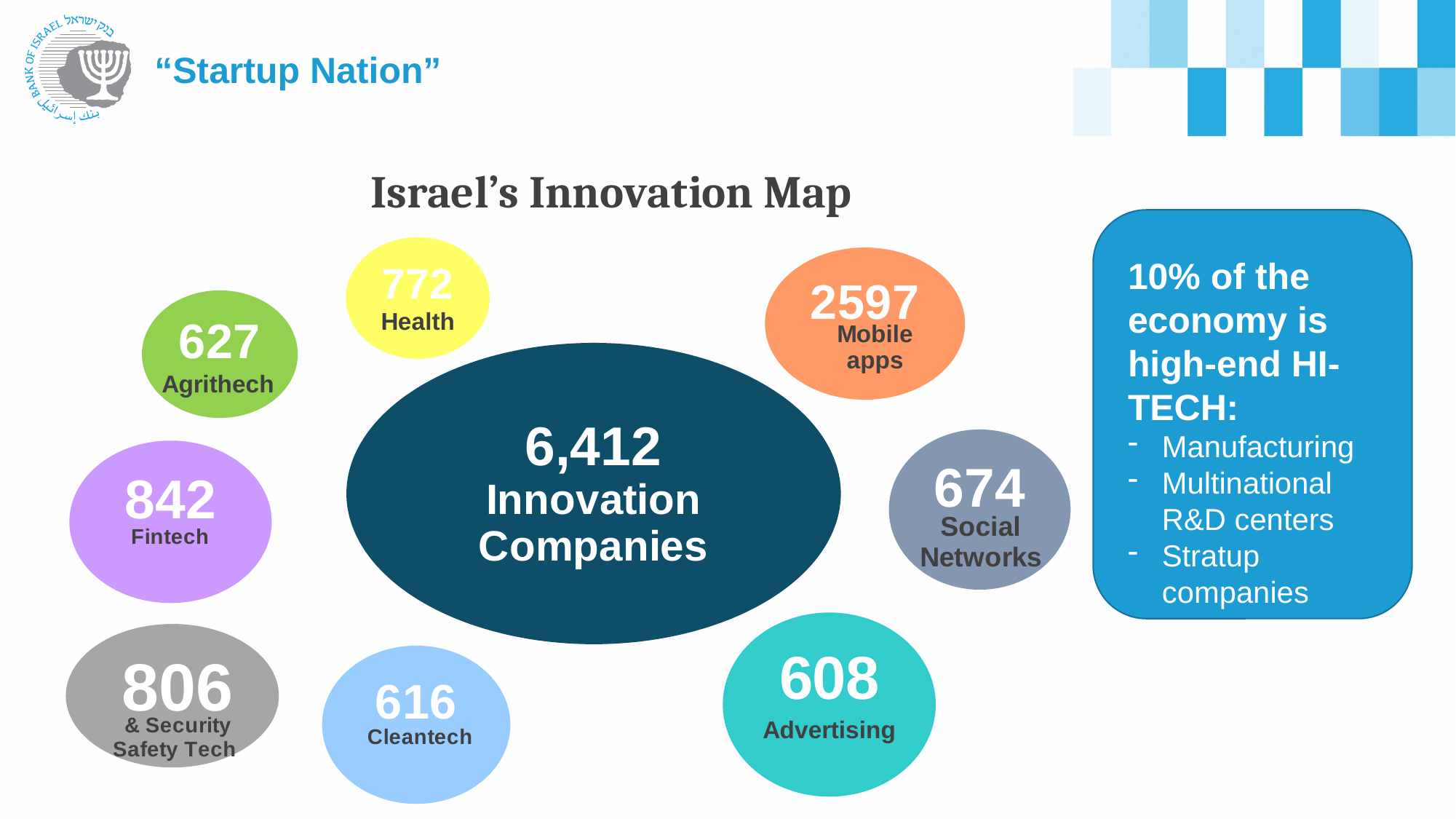
In the Israel's Innovation Map diagram, what is the value shown for Fintech? 842 In the Israel's Innovation Map diagram, which sector has the highest number of companies? Mobile apps In the Israel's Innovation Map diagram, which sector has the lowest number of companies? Advertising In the Israel's Innovation Map diagram, what is the value shown for Social Networks? 674 In the Israel's Innovation Map diagram, which has a larger value: Agrithech or Social Networks? Social Networks In the Israel's Innovation Map diagram, what is the value shown for Mobile apps? 2597 In the Israel's Innovation Map diagram, what is the difference between the Fintech and Health values? 70 How many sector bubbles surround the central 6,412 Innovation Companies bubble in the Israel's Innovation Map diagram? 8 In the Israel's Innovation Map diagram, what is the difference between the Mobile apps and Fintech values? 1755 According to the Israel's Innovation Map diagram, how many innovation companies are there in total? 6,412 What is the title of the diagram on the slide? Israel's Innovation Map In the Israel's Innovation Map diagram, what is the value shown for Cleantech? 616